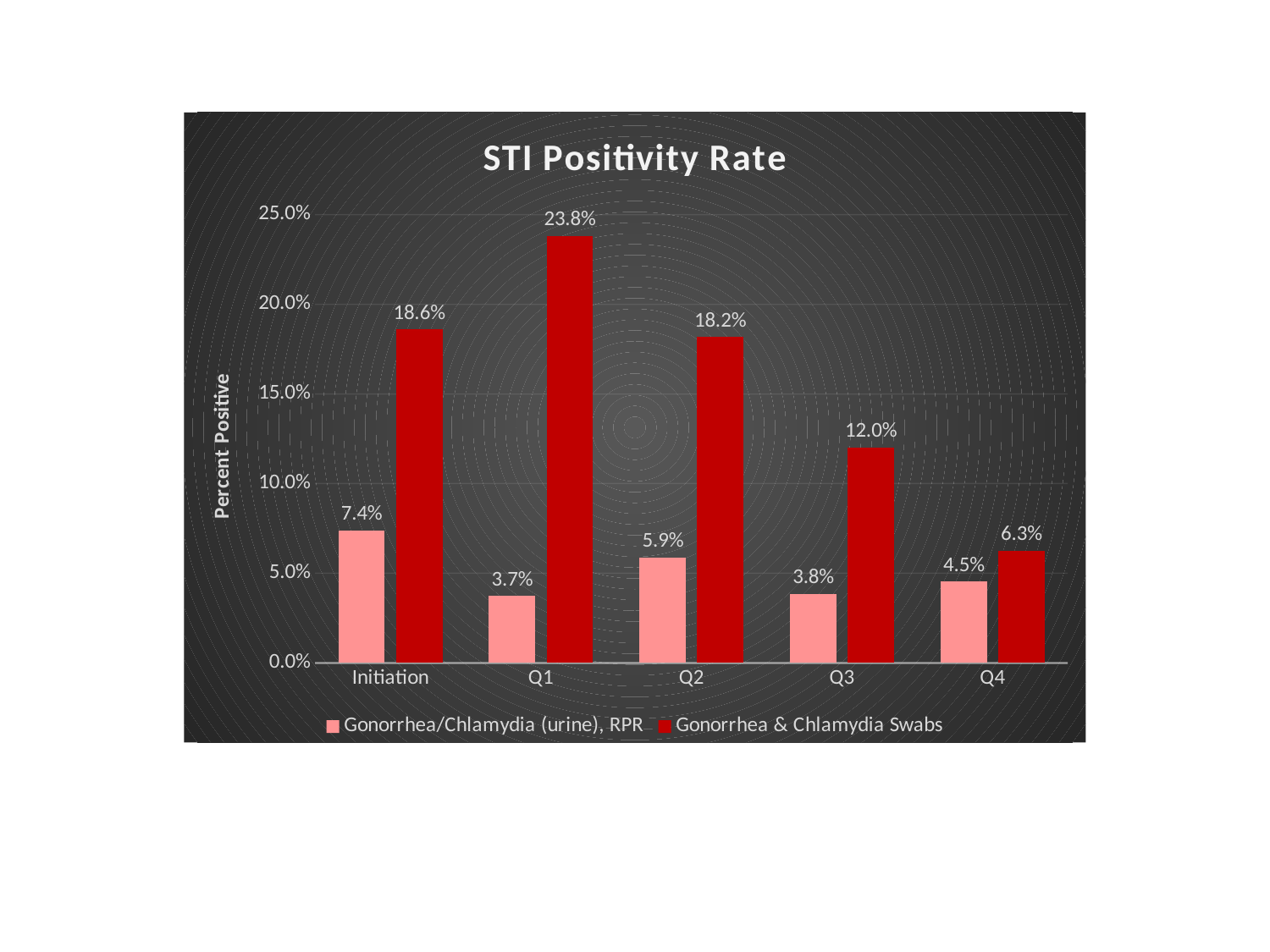
What kind of chart is shown? bar chart What is the Gonorrhea & Chlamydia Swabs value for Q4? 6.3% Which is larger: the Gonorrhea/Chlamydia (urine), RPR rate for Q3 or for Q4? Q4 Which category has the highest Gonorrhea & Chlamydia Swabs positivity rate? Q1 Is the Gonorrhea & Chlamydia Swabs value for Q3 greater or less than 10.0%? greater What is the difference between the Gonorrhea & Chlamydia Swabs rate and the Gonorrhea/Chlamydia (urine), RPR rate for Q2? 12.3% What is the title of the chart? STI Positivity Rate How many series does the legend list? 2 What is the Gonorrhea & Chlamydia Swabs positivity rate for Q1? 23.8% Which category has the lowest Gonorrhea/Chlamydia (urine), RPR positivity rate? Q1 How many categories are shown on the x axis? 5 What is the Gonorrhea/Chlamydia (urine), RPR positivity rate at Initiation? 7.4%